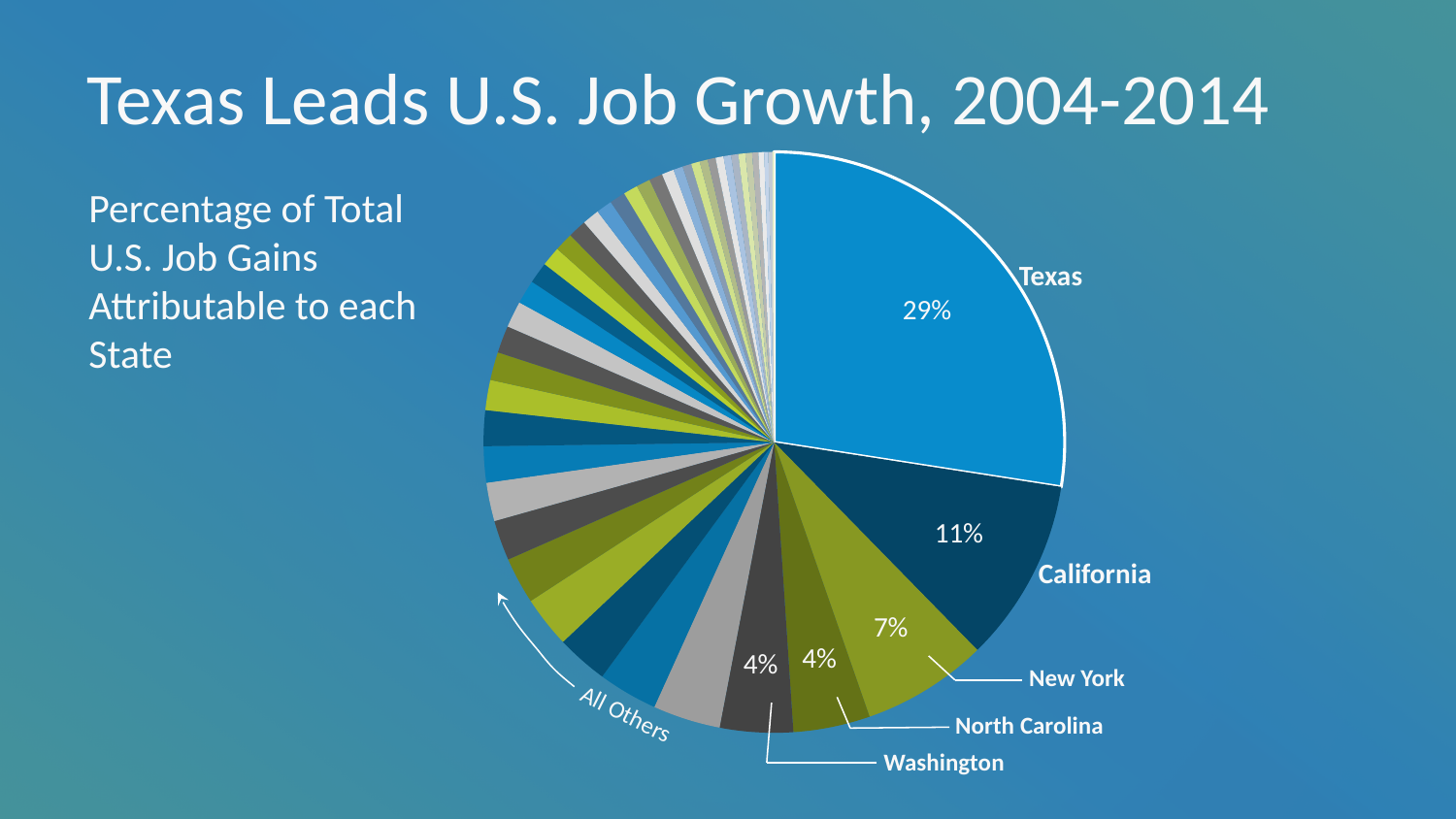
What type of chart is shown on the slide? Pie chart What percentage of total U.S. job gains is attributed to California? 11% What percentage of total U.S. job gains is attributed to New York? 7% Which state has the largest share of U.S. job gains in the chart? Texas What percentage of total U.S. job gains is attributed to North Carolina? 4% How many percentage points larger is Texas's share than California's? 18 What percentage of total U.S. job gains is attributed to Washington? 4% How many states are individually named on the chart? 5 What percentage of total U.S. job gains is attributed to Texas? 29% Which has a larger share of job gains, New York or North Carolina? New York How many percentage points larger is Texas's share than New York's? 22 Which has a larger share of job gains, California or New York? California